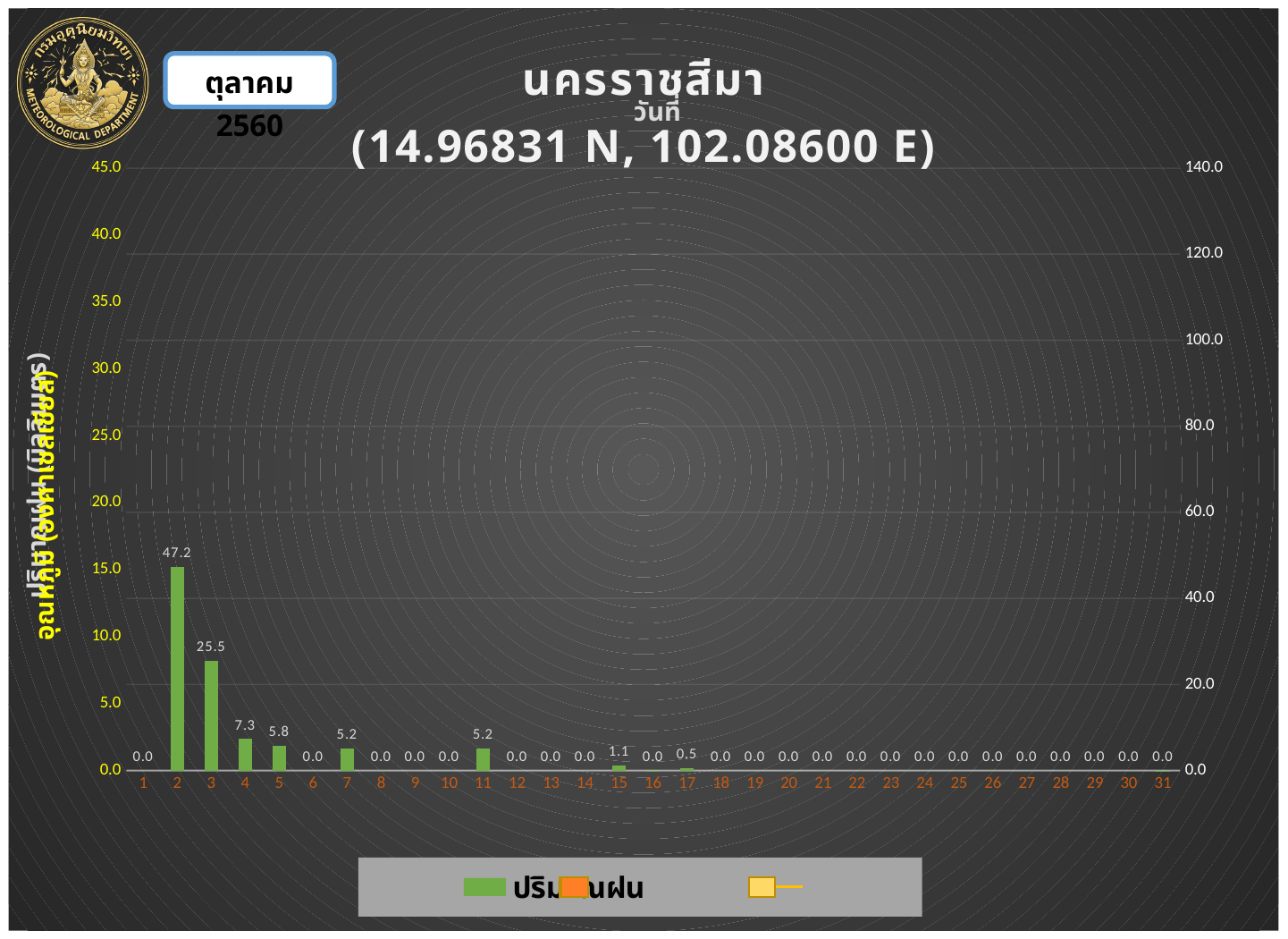
What is the difference between the values for day 2 and day 3? 21.7 What are the coordinates given in the chart title? 14.96831 N, 102.08600 E What is the value shown for day 15? 1.1 What is the difference between the values for day 4 and day 5? 1.5 What is the value shown for day 17? 0.5 Which has a larger value, day 4 or day 5? day 4 What type of chart is shown on the slide? bar chart What is the rainfall value plotted for day 2? 47.2 What is the value shown for day 11? 5.2 What is the rainfall value plotted for day 3? 25.5 Which day has the highest rainfall value? 2 How many days are shown on the x axis? 31